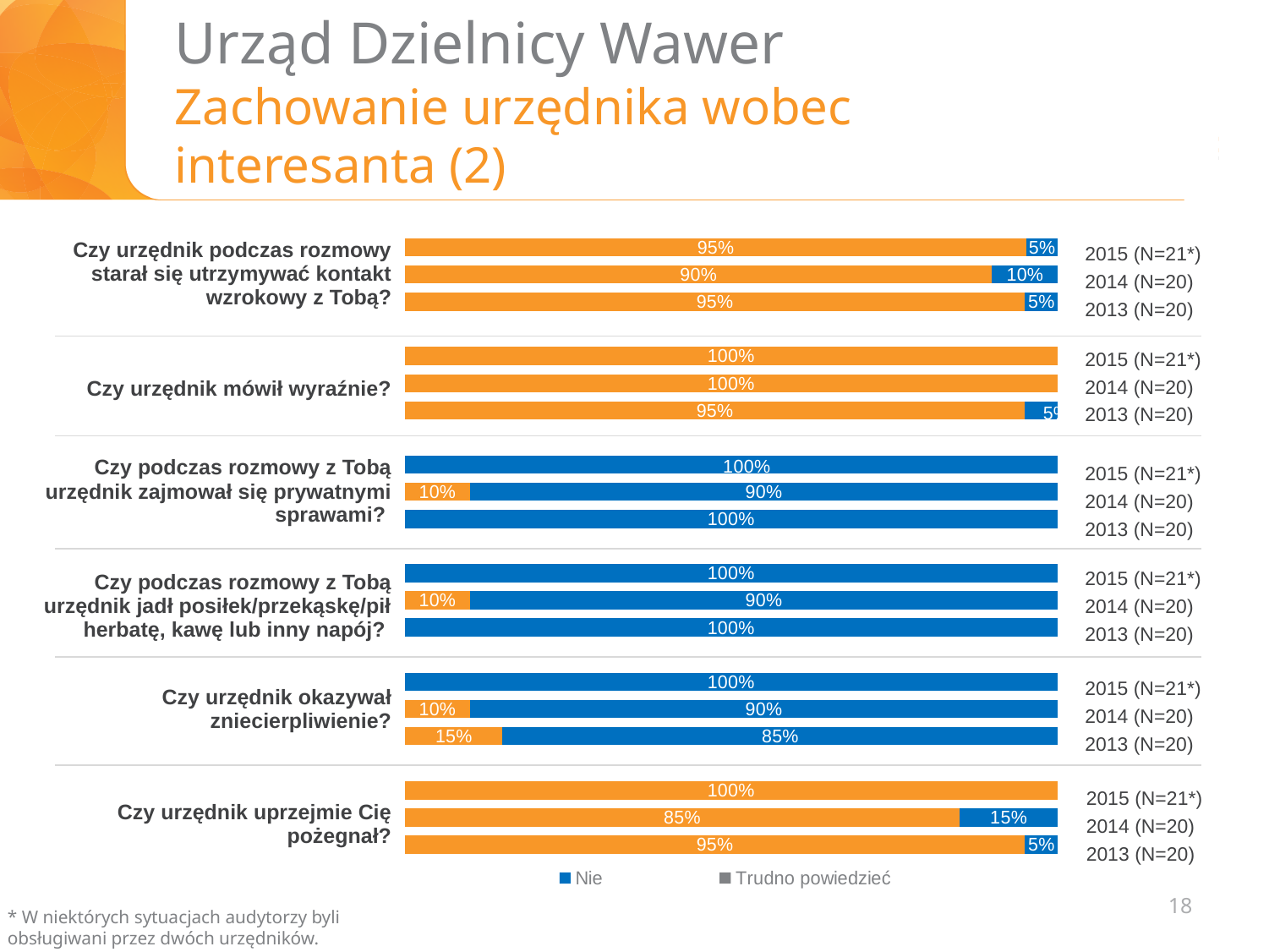
For "Czy urzędnik podczas rozmowy starał się utrzymywać kontakt wzrokowy z Tobą?" in 2014, what value is shown on the orange segment? 90% For "Czy urzędnik uprzejmie Cię pożegnał?" in 2014, what is the value of the "Nie" (blue) segment? 15% How many survey questions are shown in the chart? 6 For "Czy podczas rozmowy z Tobą urzędnik zajmował się prywatnymi sprawami?" in 2014, what is the value of the "Nie" (blue) segment? 90% Which colour represents "Nie" in the legend? Blue For "Czy urzędnik mówił wyraźnie?" in 2013, what value is shown on the orange segment? 95% For "Czy urzędnik okazywał zniecierpliwienie?" in 2013, what value is shown on the orange segment? 15% For "Czy urzędnik uprzejmie Cię pożegnał?", which year has the larger orange segment, 2014 or 2013? 2013 What is the total of the stacked bar for "Czy urzędnik podczas rozmowy starał się utrzymywać kontakt wzrokowy z Tobą?" in 2015? 100% What type of chart is shown on the slide? Bar chart For "Czy urzędnik mówił wyraźnie?" in 2015, what value is shown on the orange segment? 100% For "Czy urzędnik okazywał zniecierpliwienie?", what is the difference between the "Nie" value in 2014 and in 2013? 5 percentage points